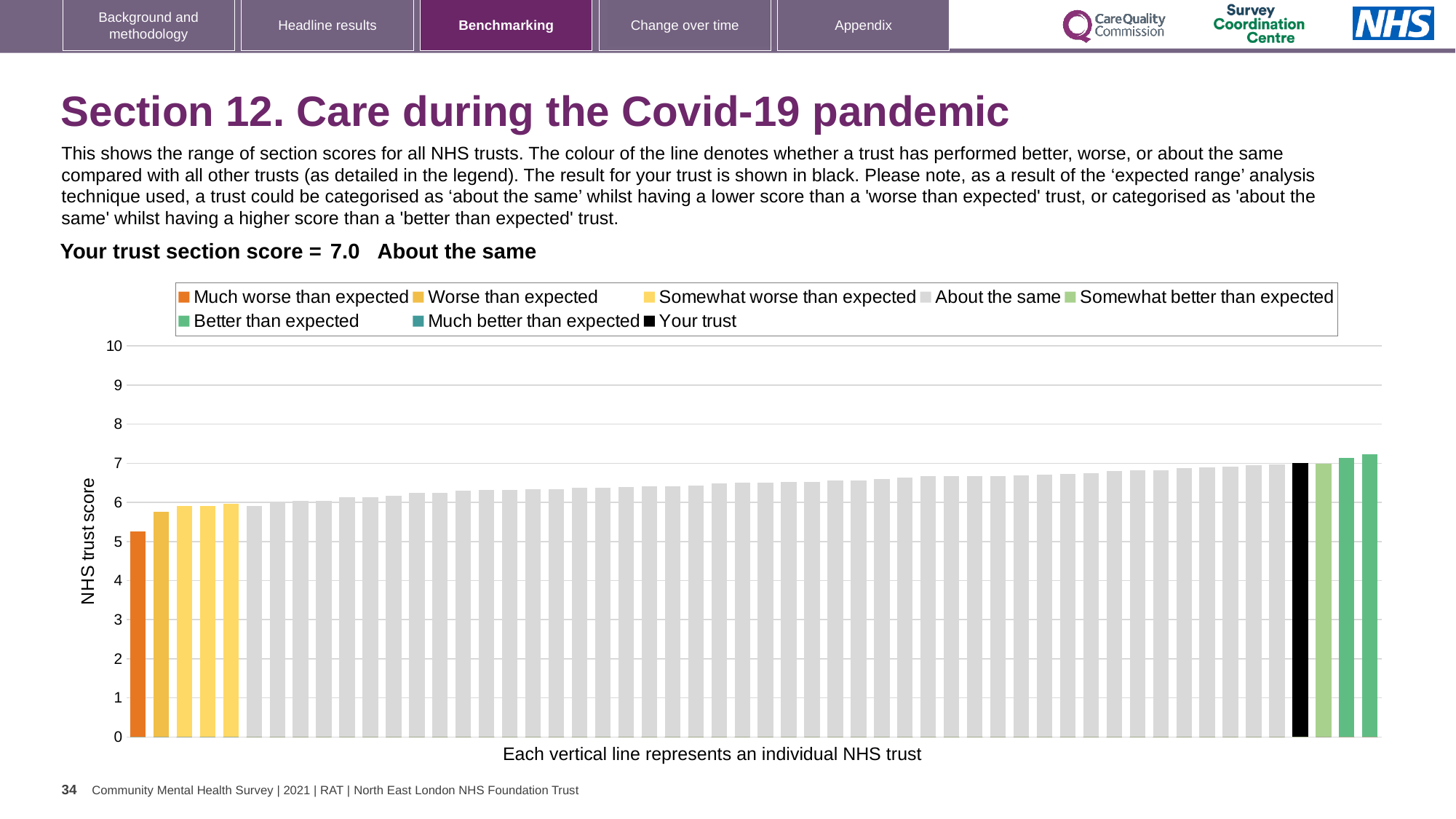
How many bars are coloured as 'Much worse than expected'? 1 How many entries does the chart legend list? 8 Which is larger: the score for your trust (black bar) or the score of the 'Much worse than expected' trust (orange bar)? your trust What kind of chart is shown on the slide? bar chart What is the label on the vertical axis of the chart? NHS trust score Which category is your trust placed in for this section? About the same Do the bar values rise or fall from left to right across the chart? rise How many bars are coloured as 'Somewhat worse than expected'? 3 What is the section score for your trust shown on the slide? 7.0 How many bars are coloured as 'Better than expected'? 2 Is the value of the highest bar in the chart greater or less than 8? less Is the value of the lowest bar (the 'Much worse than expected' trust) greater or less than 6? less